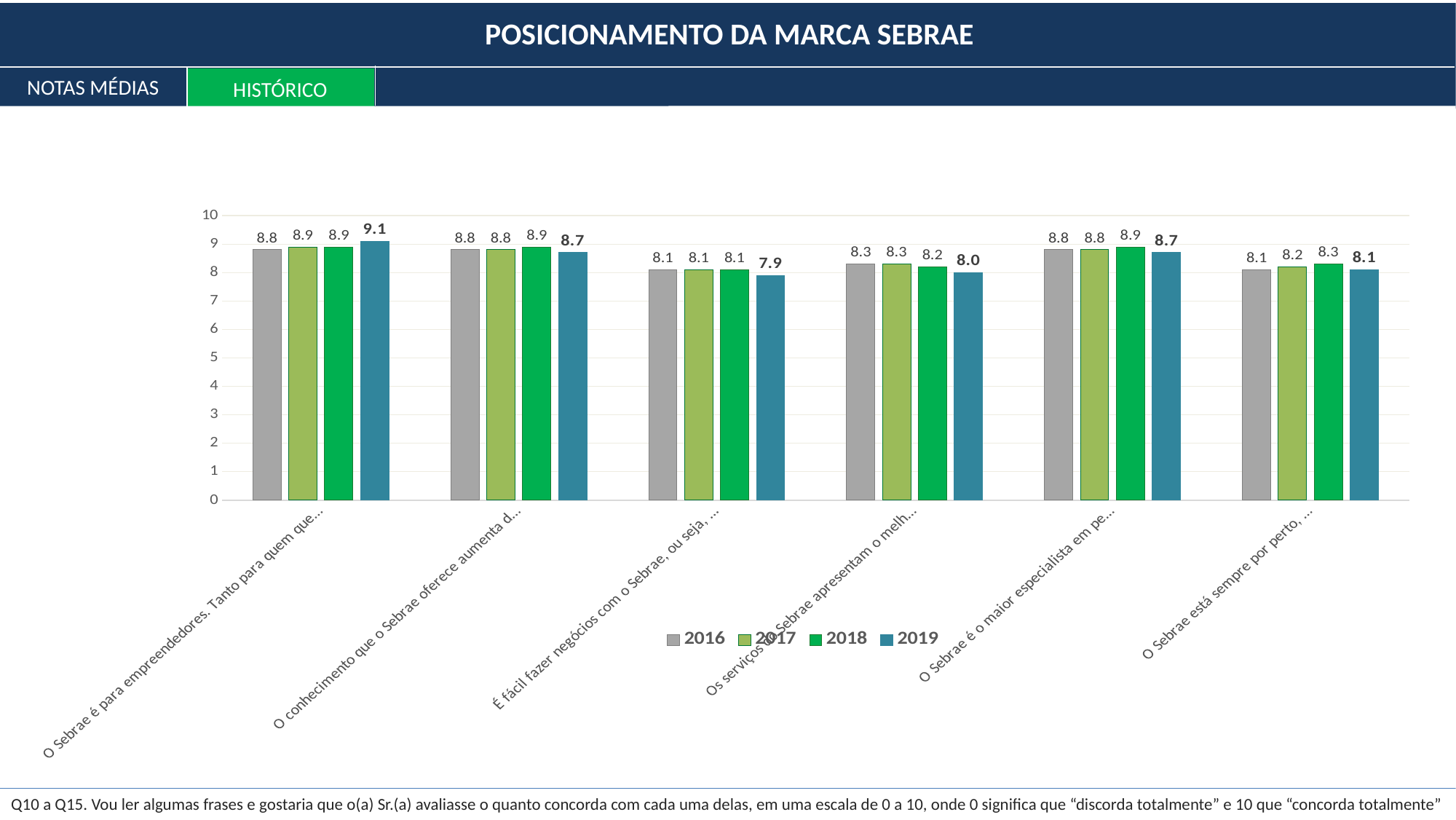
Do the values for the statement beginning "Os serviços do Sebrae apresentam" rise or fall from 2016 to 2019? fall What is the 2016 value for the statement beginning "É fácil fazer negócios com o Sebrae"? 8.1 Which statement has the highest 2019 value? O Sebrae é para empreendedores. Tanto para quem que... For the statement beginning "Os serviços do Sebrae apresentam", which is larger: the 2016 value or the 2019 value? 2016 What type of chart is shown on the slide? bar chart What is the difference between the 2019 and 2016 values for the statement beginning "O Sebrae é para empreendedores"? 0.3 What is the 2019 value for the statement beginning "O Sebrae é para empreendedores"? 9.1 How many categories (statements) are shown on the x axis? 6 Which statement has the lowest 2019 value? É fácil fazer negócios com o Sebrae, ou seja, ... What is the 2018 value for the statement beginning "O Sebrae está sempre por perto"? 8.3 How many series does the legend list? 4 Which legend entry is shown in grey? 2016